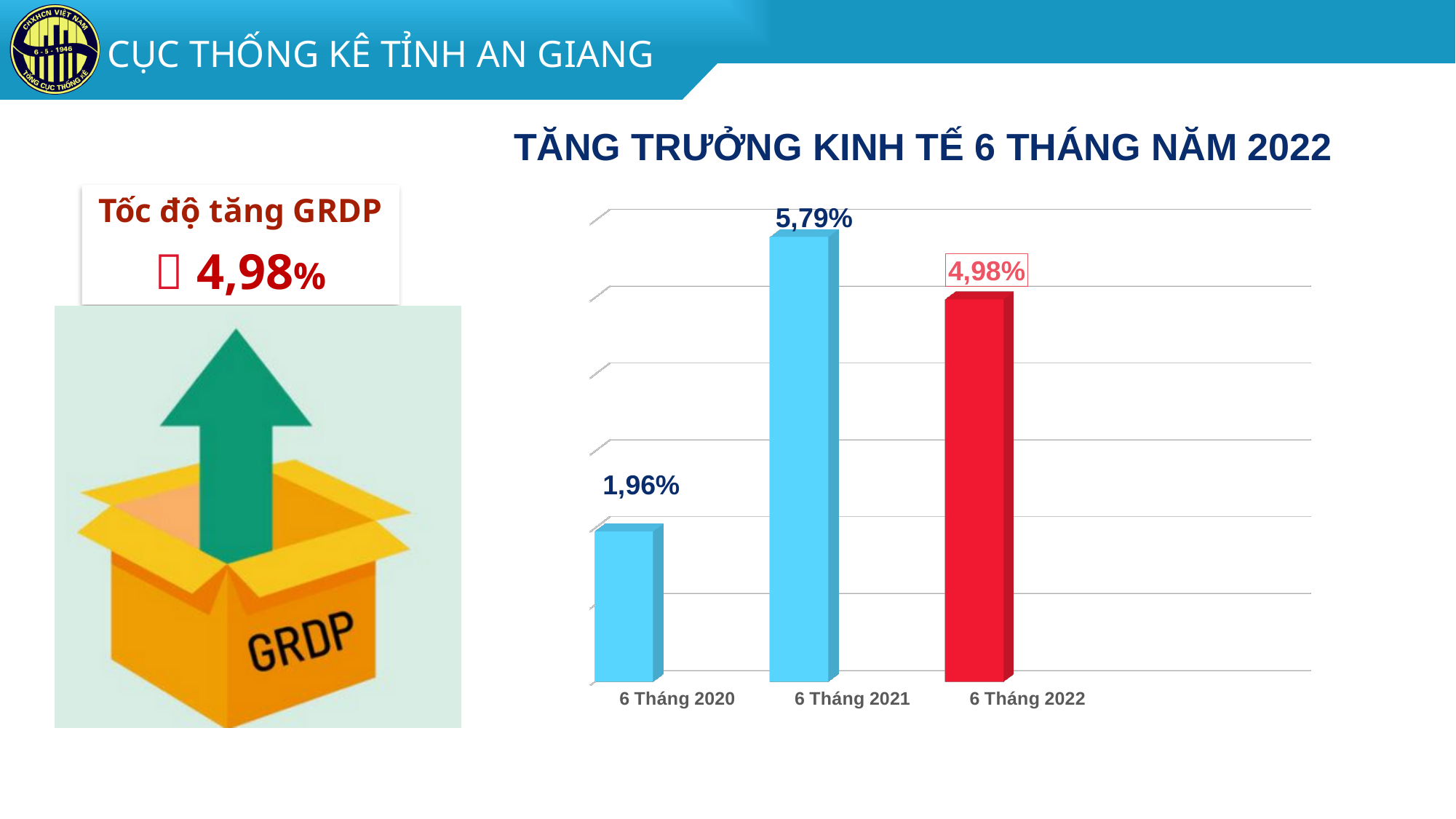
Do the values rise or fall from 6 Tháng 2021 to 6 Tháng 2022? Fall Which category has the highest value? 6 Tháng 2021 Which is larger, the value for 6 Tháng 2021 or 6 Tháng 2022? 6 Tháng 2021 What is the difference between the values for 6 Tháng 2021 and 6 Tháng 2022? 0,81% What is the value for 6 Tháng 2022? 4,98% How many categories are shown in the chart? 3 What kind of chart is shown on the slide? Bar chart What is the value for 6 Tháng 2021? 5,79% What is the value for 6 Tháng 2020? 1,96% Which category has the lowest value? 6 Tháng 2020 What is the title of the chart? TĂNG TRƯỞNG KINH TẾ 6 THÁNG NĂM 2022 What is the difference between the values for 6 Tháng 2022 and 6 Tháng 2020? 3,02%